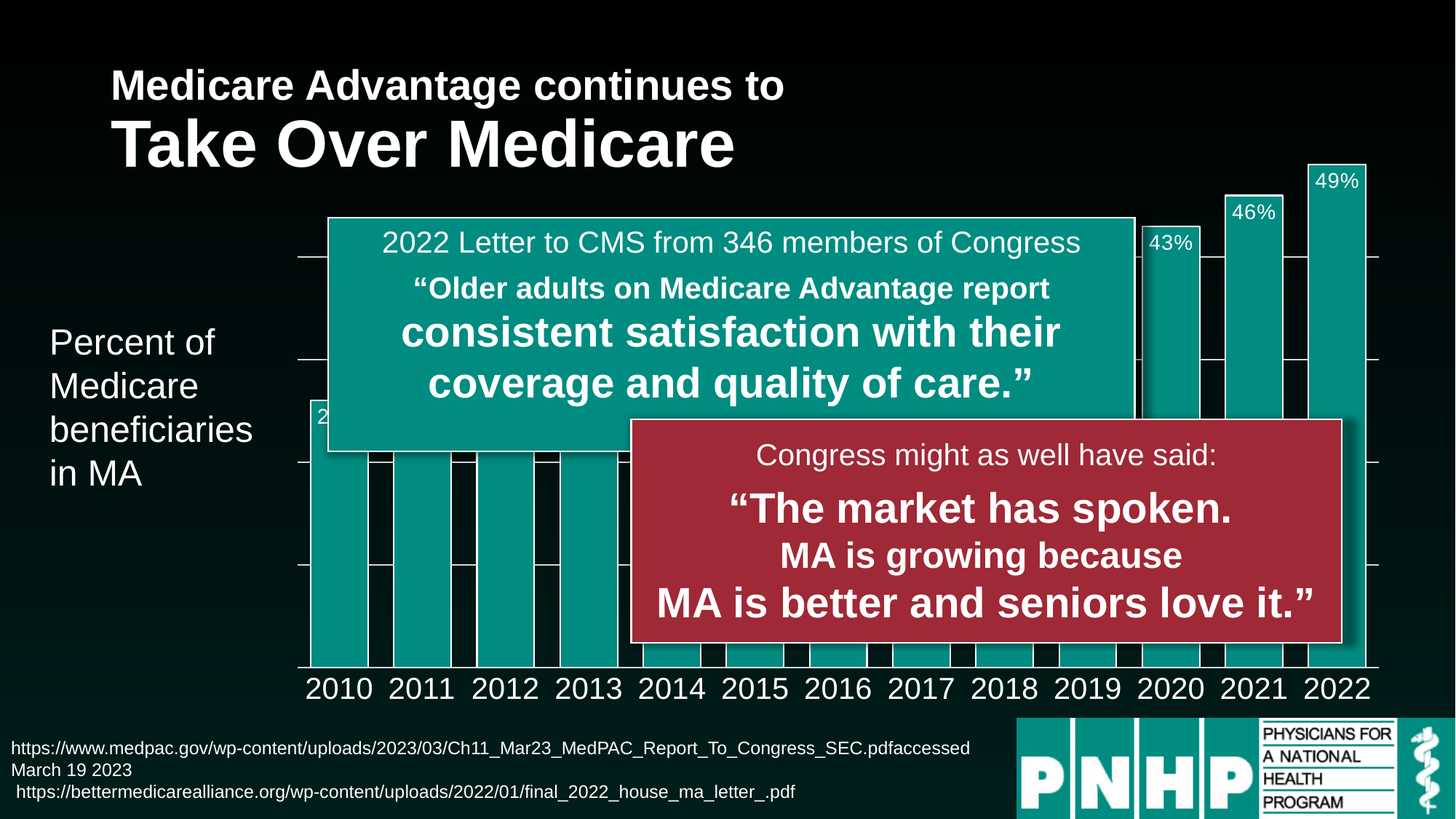
What is the difference between the values for 2021 and 2020? 3 percentage points Do the values rise or fall from 2020 to 2022? Rise What is the value for 2020? 43% What kind of chart is shown? Bar chart Which year has the highest value? 2022 What is the value for 2022? 49% What does the label to the left of the chart say the bars measure? Percent of Medicare beneficiaries in MA What is the difference between the values for 2022 and 2020? 6 percentage points Which is larger, the value for 2022 or the value for 2020? 2022 How many years are shown on the x axis? 13 What is the first year shown on the x axis? 2010 What is the value for 2021? 46%